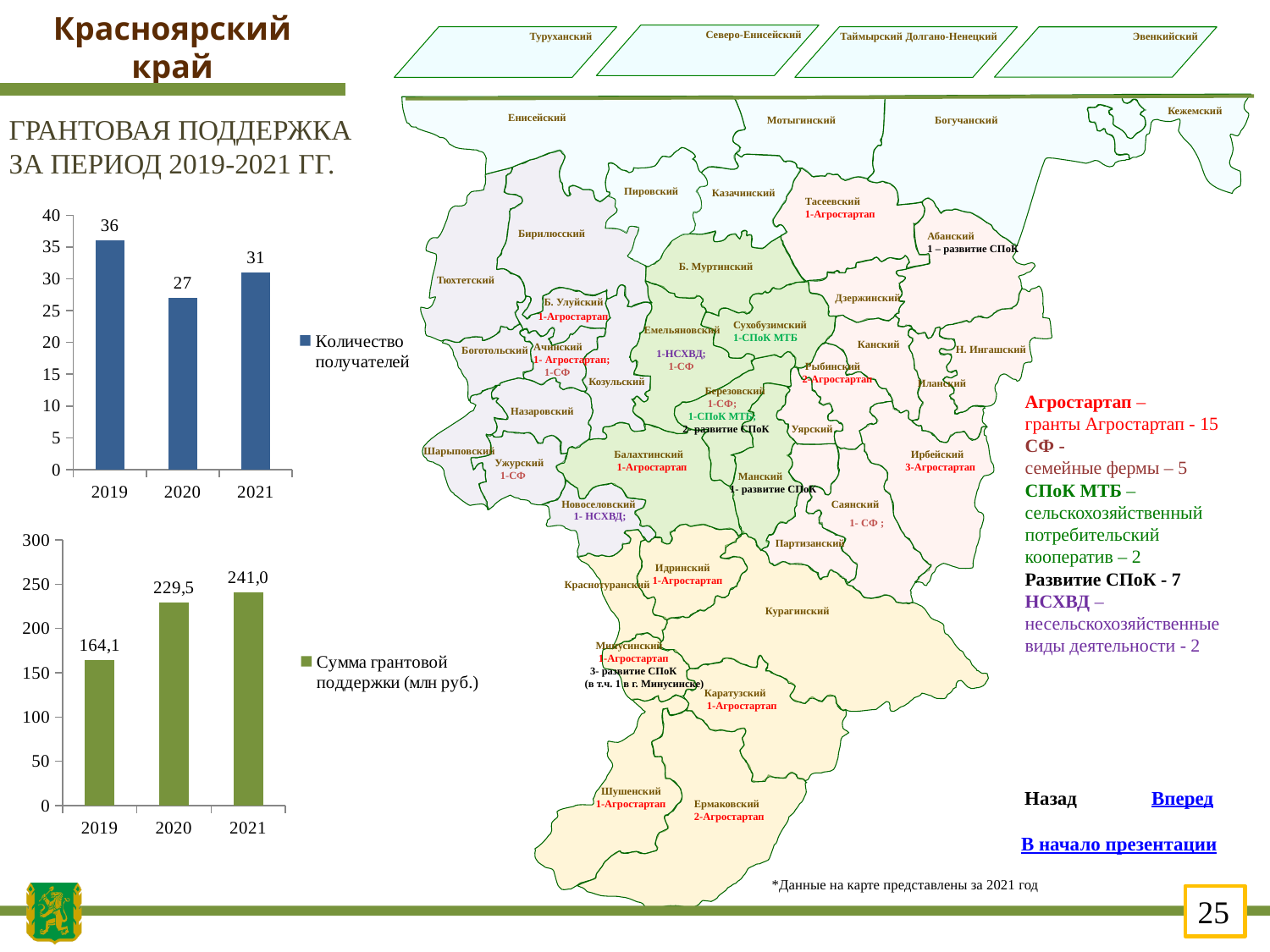
In the top chart (Количество получателей), what is the difference between the 2019 and 2021 values? 5 In the bottom chart (Сумма грантовой поддержки), which year has the highest value? 2021 In the bottom chart (Сумма грантовой поддержки), what is the value for 2019? 164,1 In the top chart (Количество получателей), how many years are shown on the x axis? 3 In the top chart (Количество получателей), what is the value for 2020? 27 In the top chart (Количество получателей), which year has the lowest value? 2020 What kind of chart is the bottom chart (Сумма грантовой поддержки)? bar chart In the bottom chart (Сумма грантовой поддержки), what is the value for 2021? 241,0 In the bottom chart (Сумма грантовой поддержки), do the values rise or fall from 2019 to 2021? rise In the bottom chart (Сумма грантовой поддержки), what is the difference between the 2020 and 2019 values? 65,4 What unit is given in the legend of the bottom chart? млн руб. In the top chart (Количество получателей), what is the value for 2019? 36